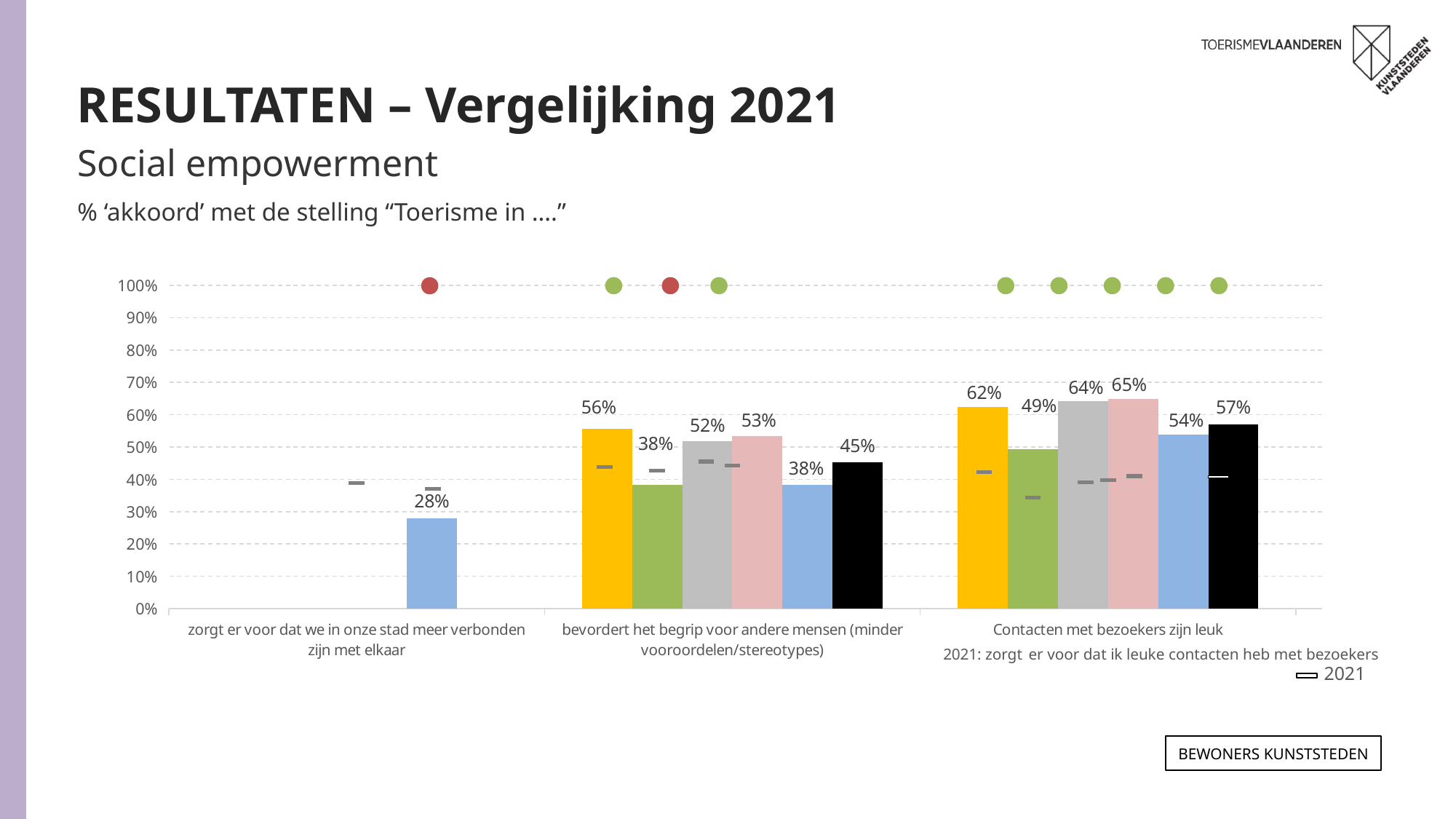
Which coloured bar is highest for "Contacten met bezoekers zijn leuk"? pink (65%) What is the value of the blue bar for "zorgt er voor dat we in onze stad meer verbonden zijn met elkaar"? 28% What kind of chart is shown on the slide? bar chart What is the value of the black bar for "Contacten met bezoekers zijn leuk"? 57% For "bevordert het begrip voor andere mensen", which is larger: the grey bar or the blue bar? the grey bar (52%) What is the difference between the yellow bar (56%) and the black bar (45%) for "bevordert het begrip voor andere mensen"? 11 percentage points Is the 2021 marker for the yellow bar in "bevordert het begrip voor andere mensen" greater or less than 50%? less Which coloured bar is lowest for "Contacten met bezoekers zijn leuk"? green (49%) How many entries does the legend list? 1 (2021) What is the value of the yellow bar for "bevordert het begrip voor andere mensen (minder vooroordelen/stereotypes)"? 56% How many statement categories are shown on the x axis? 3 What is the difference between the pink bar (65%) and the blue bar (54%) for "Contacten met bezoekers zijn leuk"? 11 percentage points